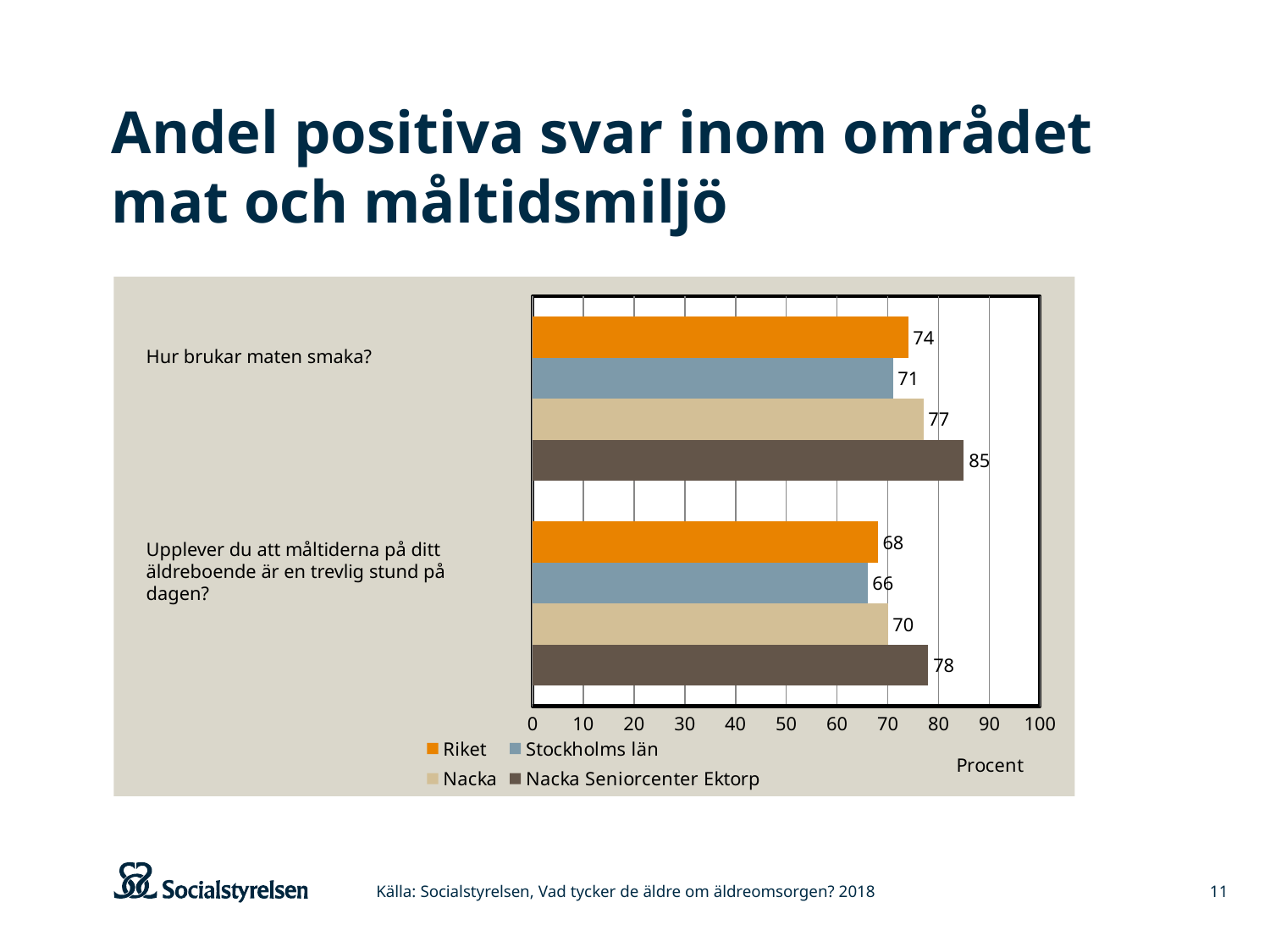
Which series has the highest value for "Upplever du att måltiderna på ditt äldreboende är en trevlig stund på dagen?"? Nacka Seniorcenter Ektorp What value does Stockholms län have for "Upplever du att måltiderna på ditt äldreboende är en trevlig stund på dagen?"? 66 What is the difference between Nacka Seniorcenter Ektorp and Riket for "Hur brukar maten smaka?"? 11 Which is larger: Nacka for "Hur brukar maten smaka?" or Nacka for "Upplever du att måltiderna på ditt äldreboende är en trevlig stund på dagen?"? Nacka for "Hur brukar maten smaka?" What is the difference between Nacka and Stockholms län for "Upplever du att måltiderna på ditt äldreboende är en trevlig stund på dagen?"? 4 How many series does the legend list? 4 What value does Riket have for "Hur brukar maten smaka?"? 74 What kind of chart is shown on the slide? Bar chart How many question categories are shown on the chart? 2 What value does Nacka Seniorcenter Ektorp have for "Hur brukar maten smaka?"? 85 What is the label of the horizontal axis? Procent Which series has the lowest value for "Hur brukar maten smaka?"? Stockholms län